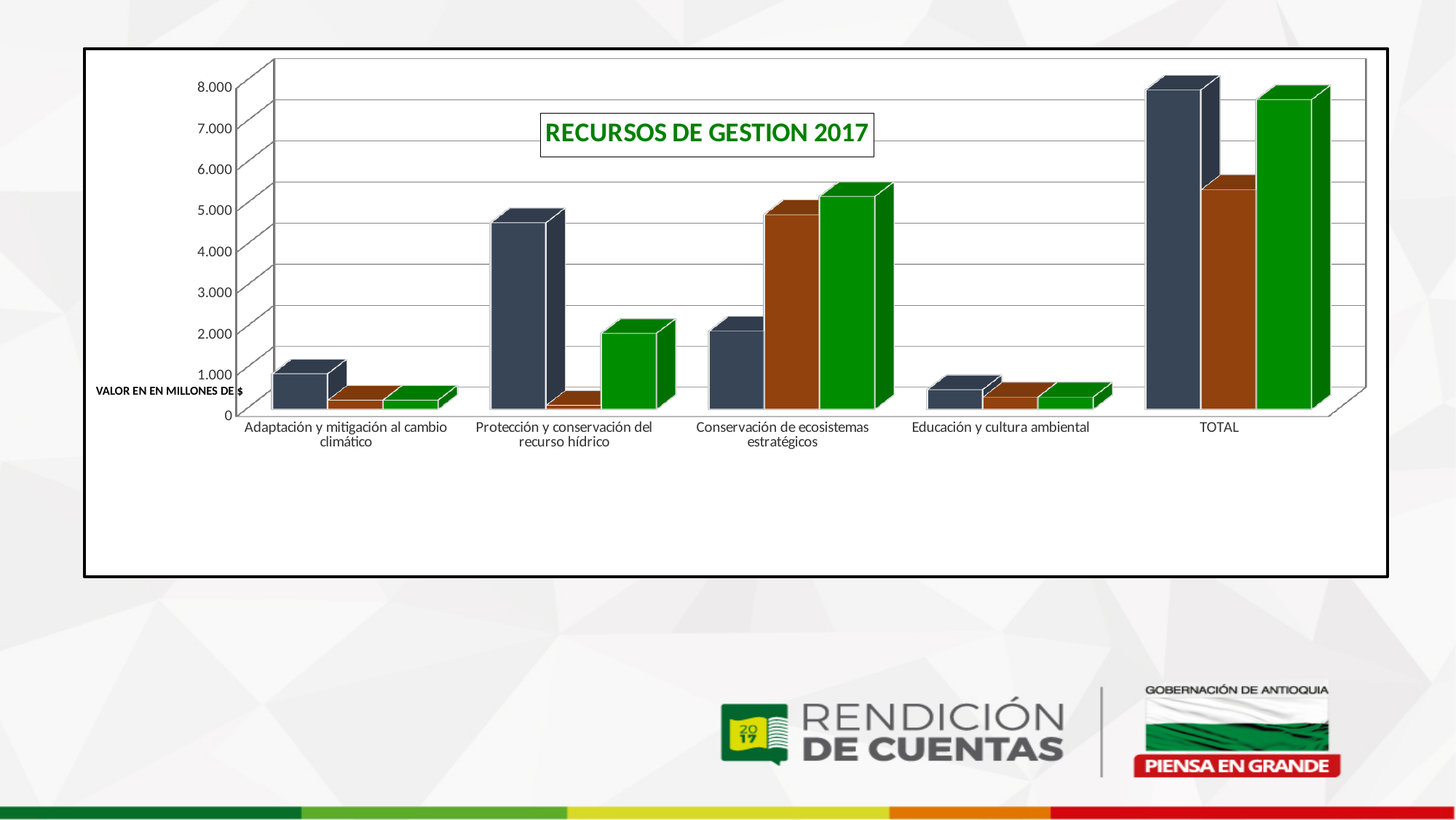
Is the dark gray bar for TOTAL greater or less than 7.000? greater Is the brown bar for TOTAL greater or less than 4.000? greater Excluding TOTAL, which category has the tallest dark gray bar? Protección y conservación del recurso hídrico How many categories are shown on the x axis of the chart? 5 What type of chart is shown on the slide? bar chart For Conservación de ecosistemas estratégicos, which is larger: the green bar or the dark gray bar? the green bar What is the title of the chart? RECURSOS DE GESTION 2017 Is the green bar for Conservación de ecosistemas estratégicos greater or less than 4.000? greater For Protección y conservación del recurso hídrico, which is larger: the dark gray bar or the green bar? the dark gray bar What is the label on the vertical axis of the chart? VALOR EN EN MILLONES DE $